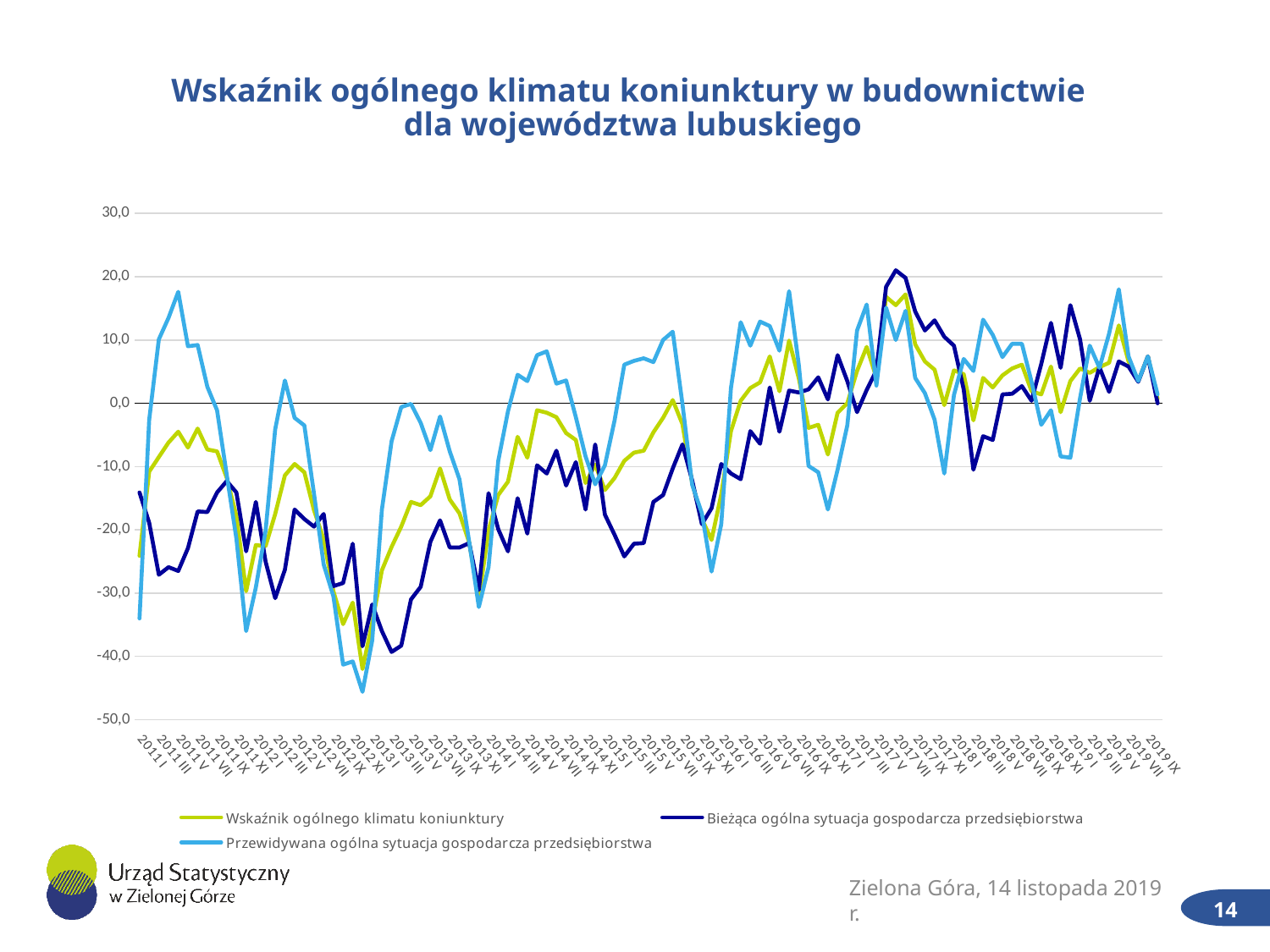
What kind of chart is shown on the slide? line chart Is the value of the 'Bieżąca ogólna sytuacja gospodarcza przedsiębiorstwa' series at 2013 I greater or less than -30,0? less Is the value of the 'Bieżąca ogólna sytuacja gospodarcza przedsiębiorstwa' series at 2017 V greater or less than 10,0? less Is the value of the 'Przewidywana ogólna sytuacja gospodarcza przedsiębiorstwa' series at 2011 V greater or less than 10,0? greater How many series does the legend list? 3 Overall, do the values of the 'Wskaźnik ogólnego klimatu koniunktury' series rise or fall from 2011 I to 2019 IX? rise Which series is drawn with the yellow-green line? Wskaźnik ogólnego klimatu koniunktury What is the title of the chart? Wskaźnik ogólnego klimatu koniunktury w budownictwie dla województwa lubuskiego